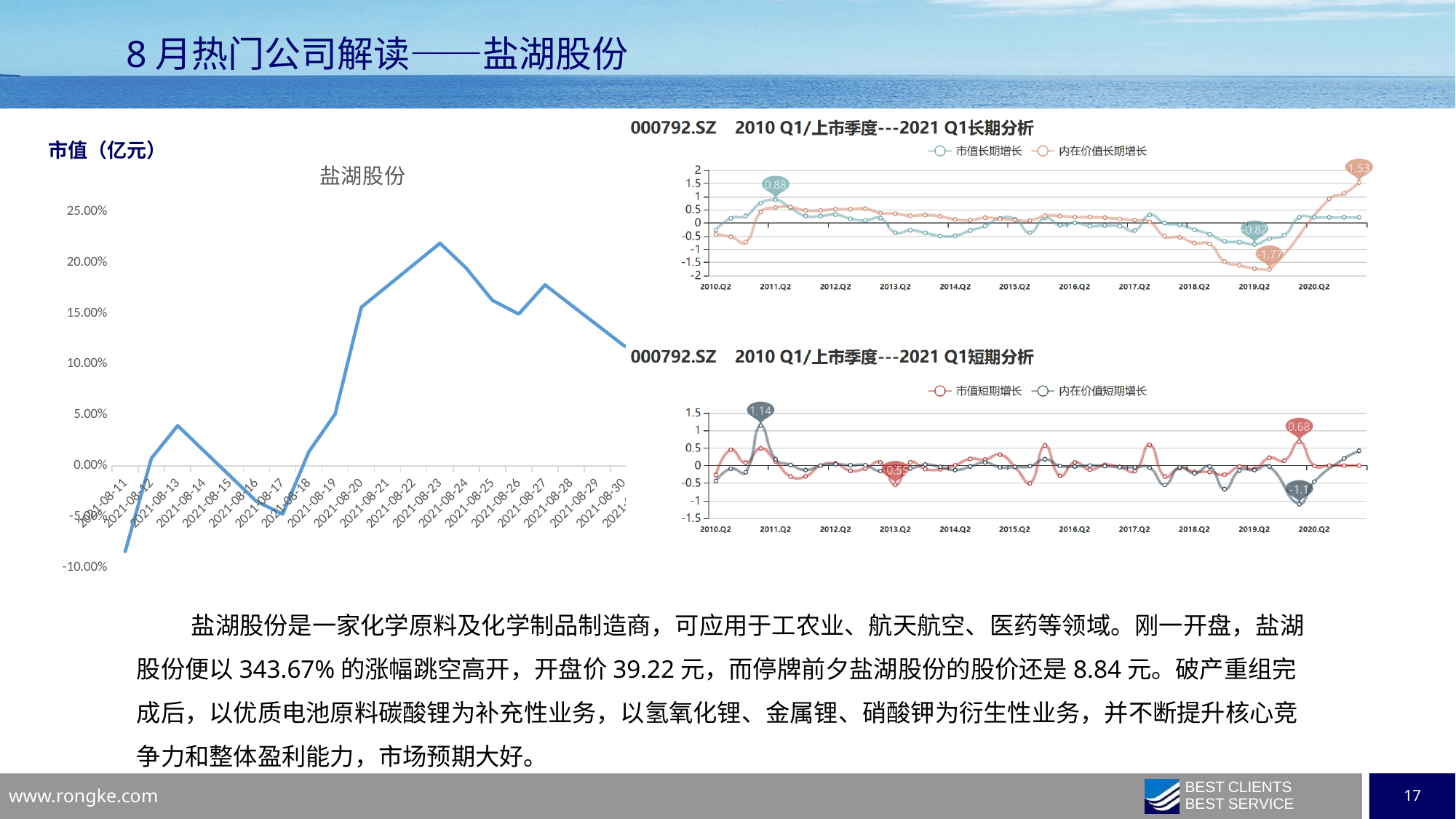
In the top-right chart (长期分析), what is the labeled peak value of 市值长期增长 near 2011.Q2? 0.88 In the left chart titled 盐湖股份, is the value for 2021-08-23 greater or less than 20.00%? greater In the top-right chart (长期分析), what is the highest labeled value shown for 内在价值长期增长? 1.53 What kind of chart is the left chart titled 盐湖股份? line chart In the left chart titled 盐湖股份, is the value for 2021-08-13 greater or less than 5.00%? less In the bottom-right chart (短期分析), what is the labeled peak value of 市值短期增长 near 2019.Q2? 0.68 How many series does the legend of the top-right chart (长期分析) list? 2 In the left chart titled 盐湖股份, which date has the larger value, 2021-08-23 or 2021-08-27? 2021-08-23 In the top-right chart (长期分析), what is the lowest labeled value shown for 内在价值长期增长? -1.77 In the left chart titled 盐湖股份, on which date does the line reach its highest value? 2021-08-23 In the bottom-right chart (短期分析), what is the highest labeled value shown for 内在价值短期增长? 1.14 In the left chart titled 盐湖股份, on which date is the line at its lowest value? 2021-08-11